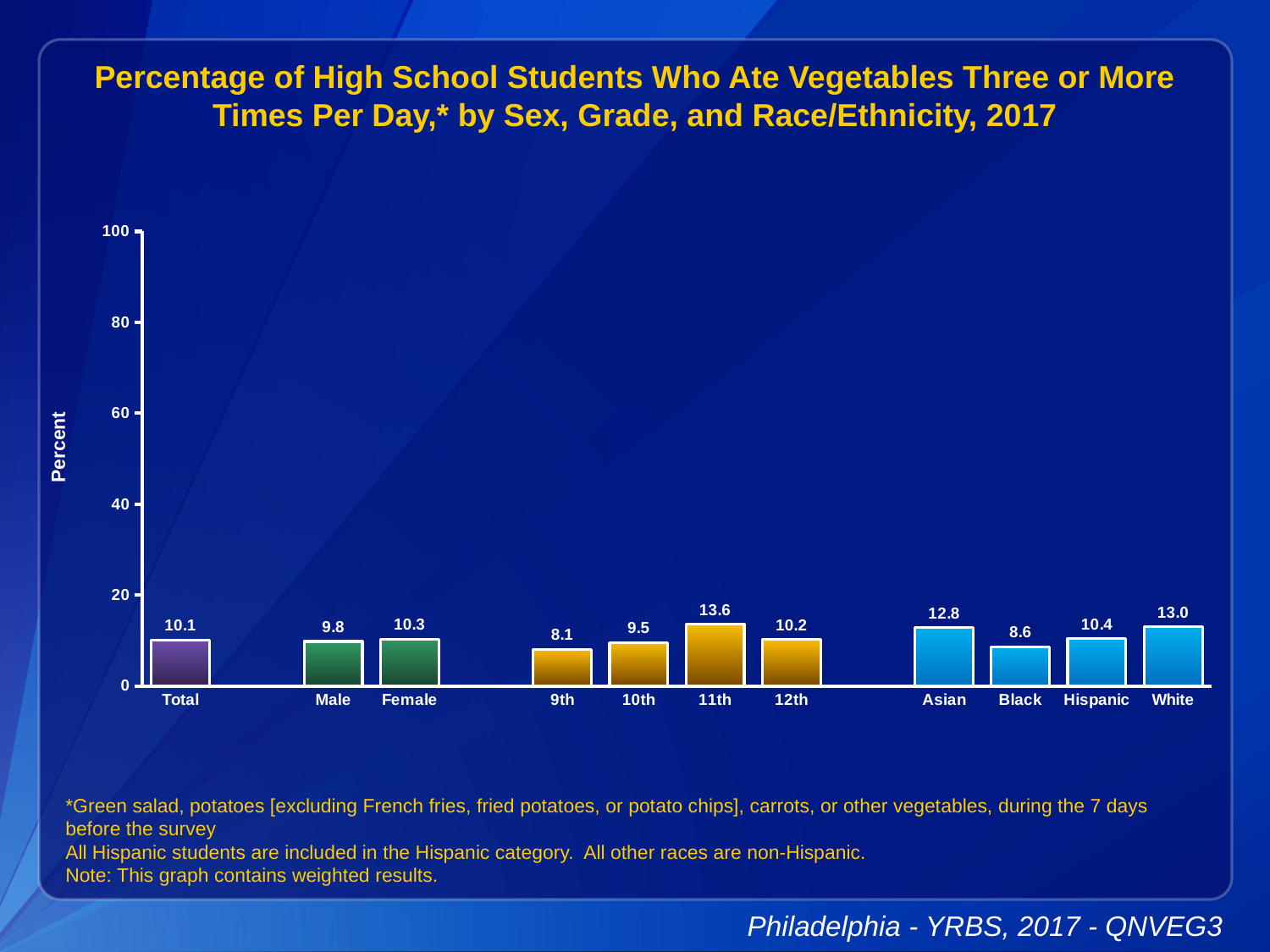
What kind of chart is shown on the slide? bar chart What is the difference between the Female and Male values? 0.5 Is the value for 11th grade greater or less than 20? less Which category has the highest value on the chart? 11th Which is larger, the value for Asian or the value for Hispanic? Asian What is the difference between the White and Black values? 4.4 What is the label of the y axis? Percent How many categories are shown on the x axis? 11 Which category has the lowest value on the chart? 9th What is the value for Black students? 8.6 What is the value for Total? 10.1 What percentage of 11th grade students ate vegetables three or more times per day? 13.6